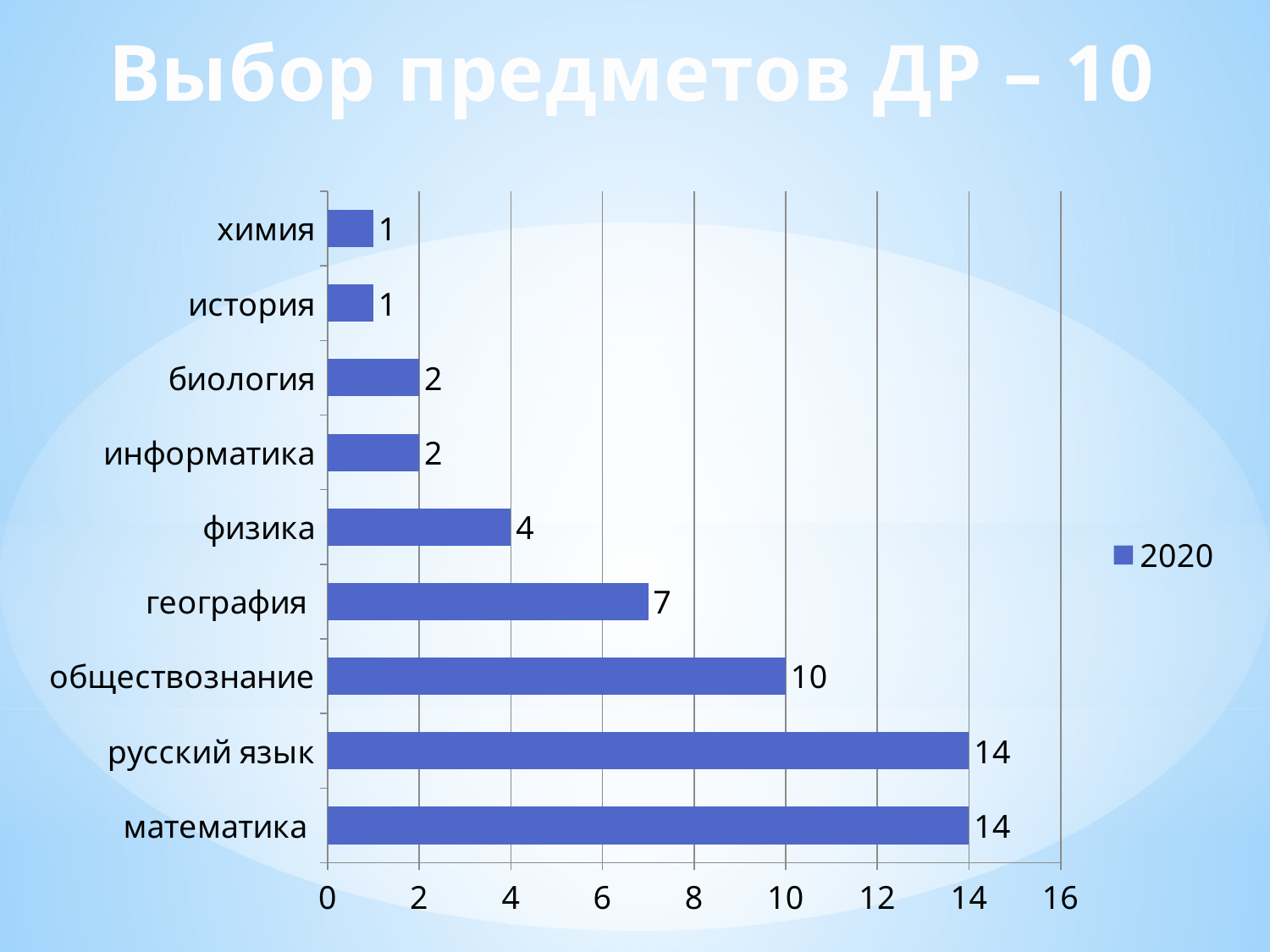
What is the title of the chart on the slide? Выбор предметов ДР – 10 What is the difference between the values for русский язык and обществознание? 4 What is the difference between the values for география and биология? 5 What is the value for физика? 4 How many categories are shown on the chart? 9 How many series does the legend list? 1 What is the value for обществознание? 10 What kind of chart is shown on the slide? bar chart Is the value for обществознание greater or less than 8? greater Which category has the lowest value, физика or география? физика What is the value for химия? 1 What is the value for география? 7